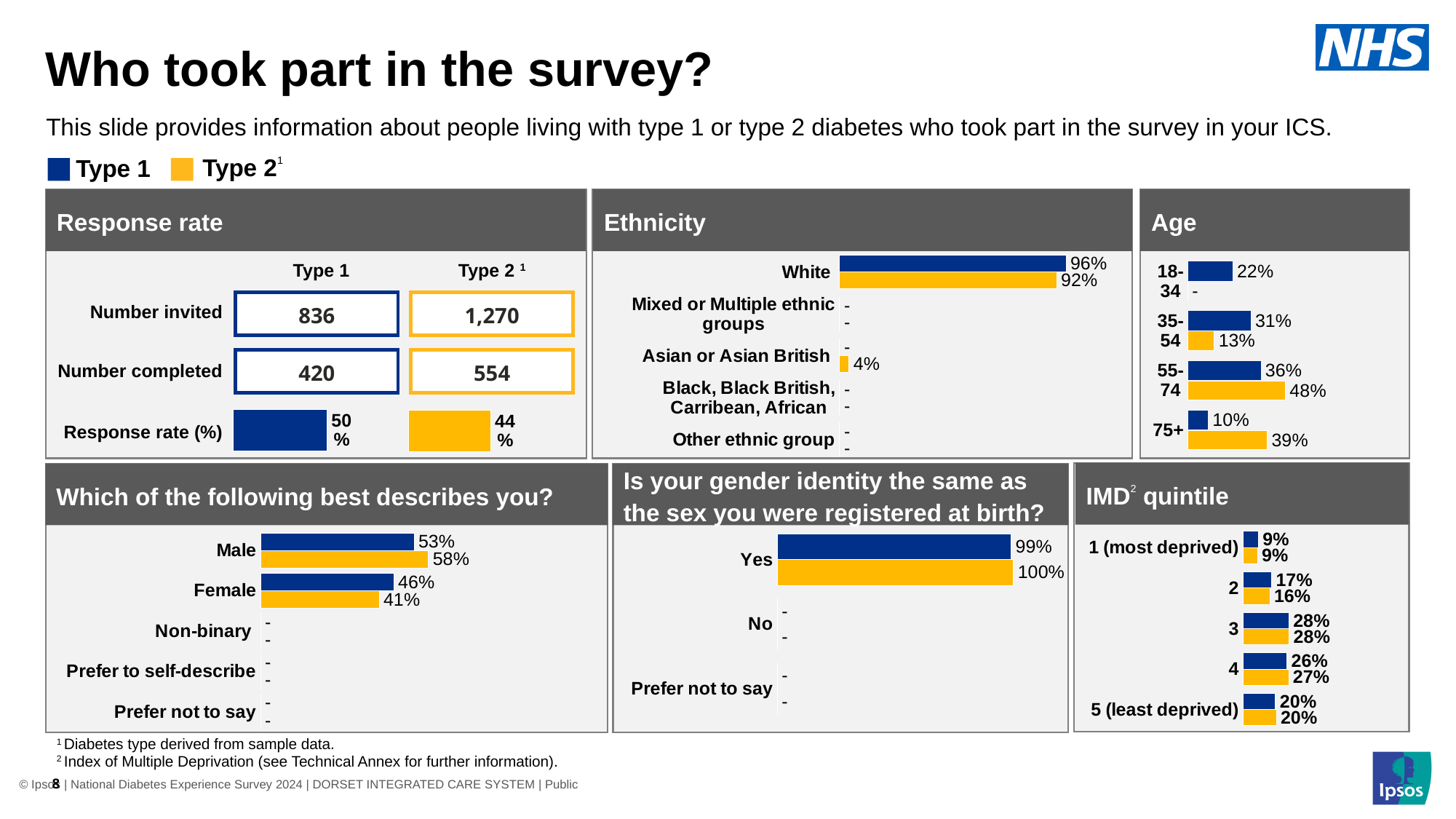
In the Age chart, what is the difference between the Type 2 and Type 1 values for 55-74? 12% In the Age chart, which age group has the highest Type 1 value? 55-74 In the Response rate chart, what is the response rate for Type 1? 50% In the Response rate chart, what is the number completed for Type 2? 554 In the Age chart, what is the Type 2 value for 75+? 39% In the Ethnicity chart, what is the Type 2 value for Asian or Asian British? 4% In the gender identity chart, what is the Type 2 value for Yes? 100% In the 'Which of the following best describes you?' chart, what is the Type 1 value for Female? 46% In the 'Which of the following best describes you?' chart, which is larger for Type 2: Male or Female? Male In the IMD quintile chart, what is the Type 2 value for quintile 4? 27% In the IMD quintile chart, which quintile has the lowest Type 1 value? 1 (most deprived) In the Ethnicity chart, what is the Type 2 value for White? 92%